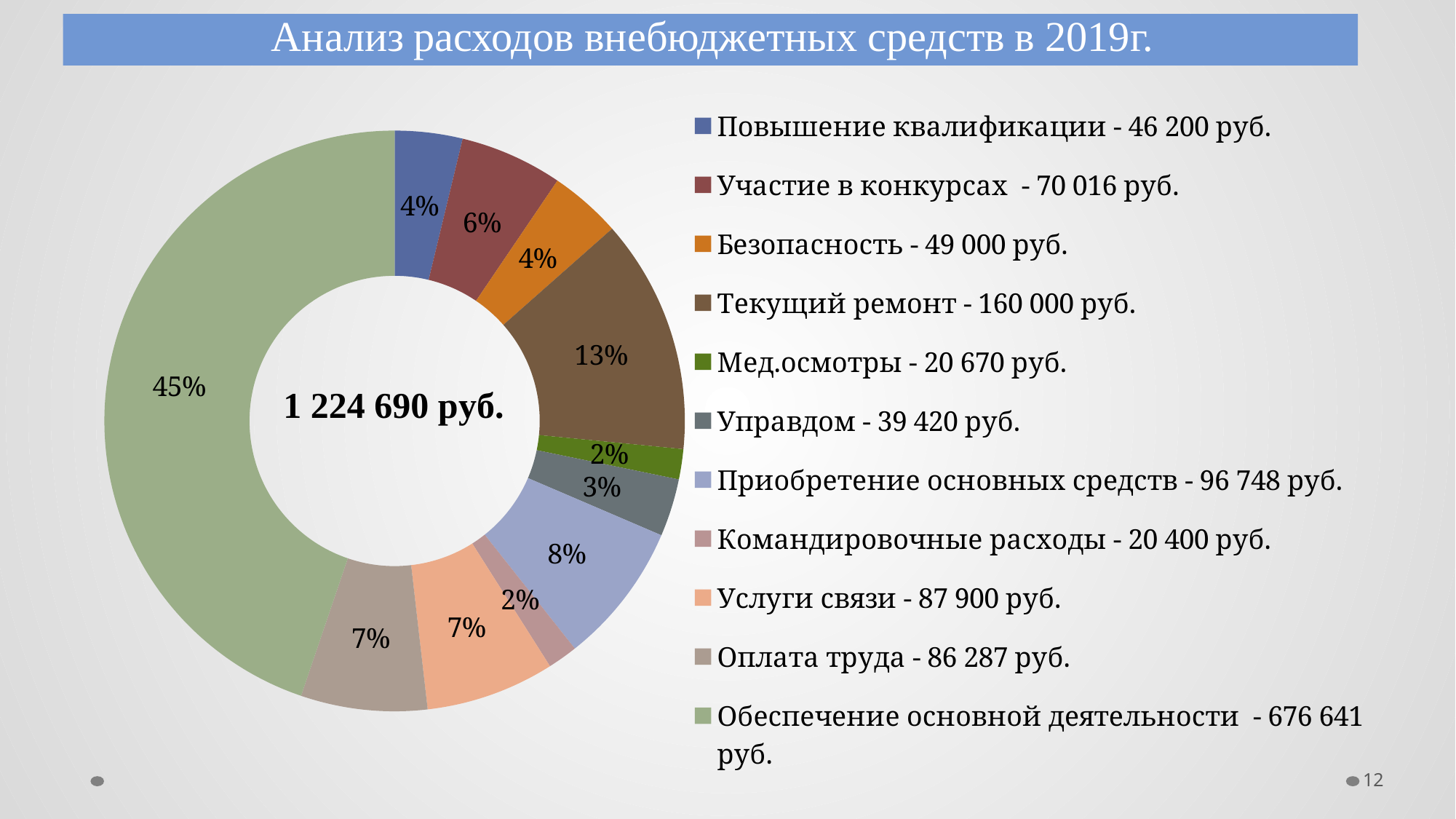
What share of expenses does Текущий ремонт account for? 13% What is the title of the chart on the slide? Анализ расходов внебюджетных средств в 2019г. What total amount is shown in the centre of the chart? 1 224 690 руб. What is the amount in rubles for Текущий ремонт? 160 000 руб. Which category has the largest share of expenses? Обеспечение основной деятельности Which is larger: the share for Участие в конкурсах or for Повышение квалификации? Участие в конкурсах What kind of chart is shown on the slide? doughnut (pie) chart What share of expenses does Обеспечение основной деятельности account for? 45% What is the difference in rubles between Текущий ремонт and Безопасность? 111 000 руб. What is the amount in rubles for Услуги связи? 87 900 руб. How many expense categories does the chart show? 11 Which category has the smallest amount in rubles according to the legend? Командировочные расходы - 20 400 руб.